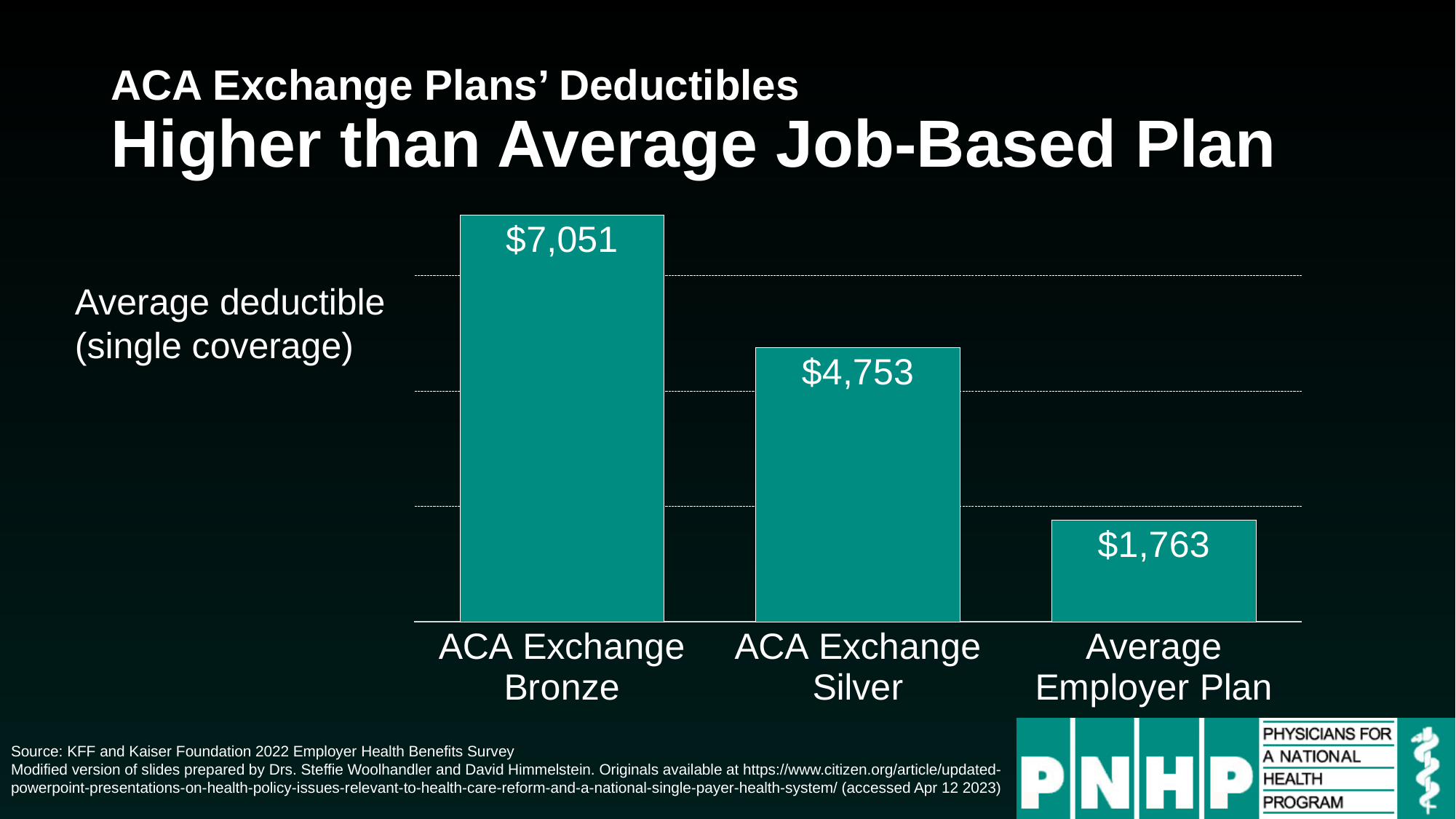
Which has a larger average deductible, ACA Exchange Silver or Average Employer Plan? ACA Exchange Silver What is the average deductible for the ACA Exchange Silver plan? $4,753 How many plan categories are shown in the chart? 3 What does the label to the left of the chart say the bars represent? Average deductible (single coverage) Which plan has the lowest average deductible? Average Employer Plan What is the average deductible for the ACA Exchange Bronze plan? $7,051 What is the difference between the ACA Exchange Bronze and ACA Exchange Silver deductibles? $2,298 Which plan has the highest average deductible? ACA Exchange Bronze How much higher is the ACA Exchange Bronze deductible than the Average Employer Plan deductible? $5,288 What type of chart is shown on the slide? Bar chart What is the average deductible for the Average Employer Plan? $1,763 Do the deductible values rise or fall from left to right across the chart? Fall